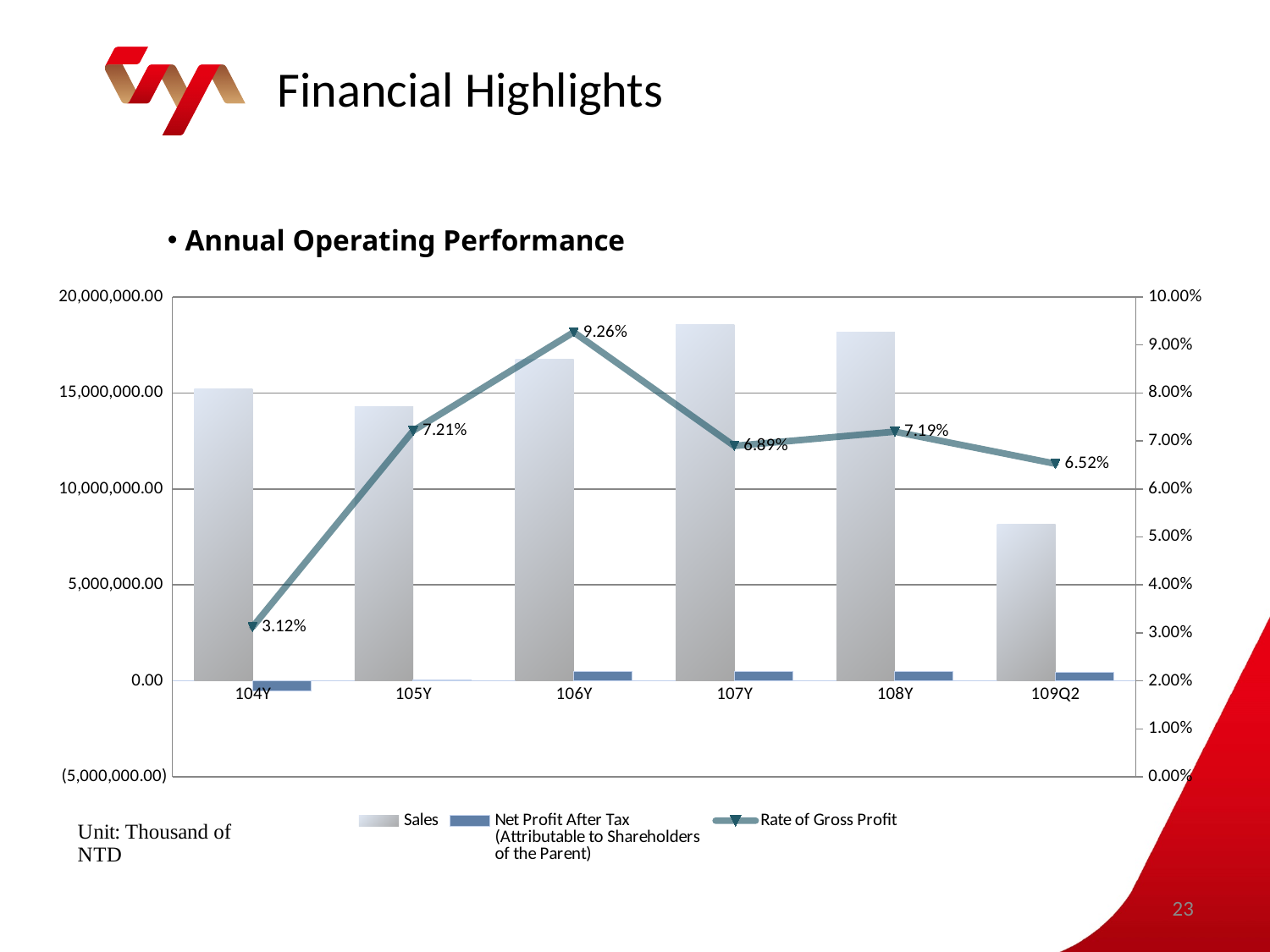
What is the Rate of Gross Profit for 106Y? 9.26% Which period has the highest Rate of Gross Profit? 106Y How many periods are shown on the x axis? 6 Which period has the lowest Rate of Gross Profit? 104Y What is the difference between the Rate of Gross Profit in 106Y and in 104Y? 6.14 percentage points Is the Sales value for 109Q2 greater or less than 10,000,000.00? less Which is larger, the Rate of Gross Profit in 107Y or in 108Y? 108Y What is the Rate of Gross Profit for 104Y? 3.12% Is the Sales value for 107Y greater or less than 15,000,000.00? greater What is the Rate of Gross Profit for 109Q2? 6.52% Which period has the lowest Sales? 109Q2 How many series does the legend list? 3